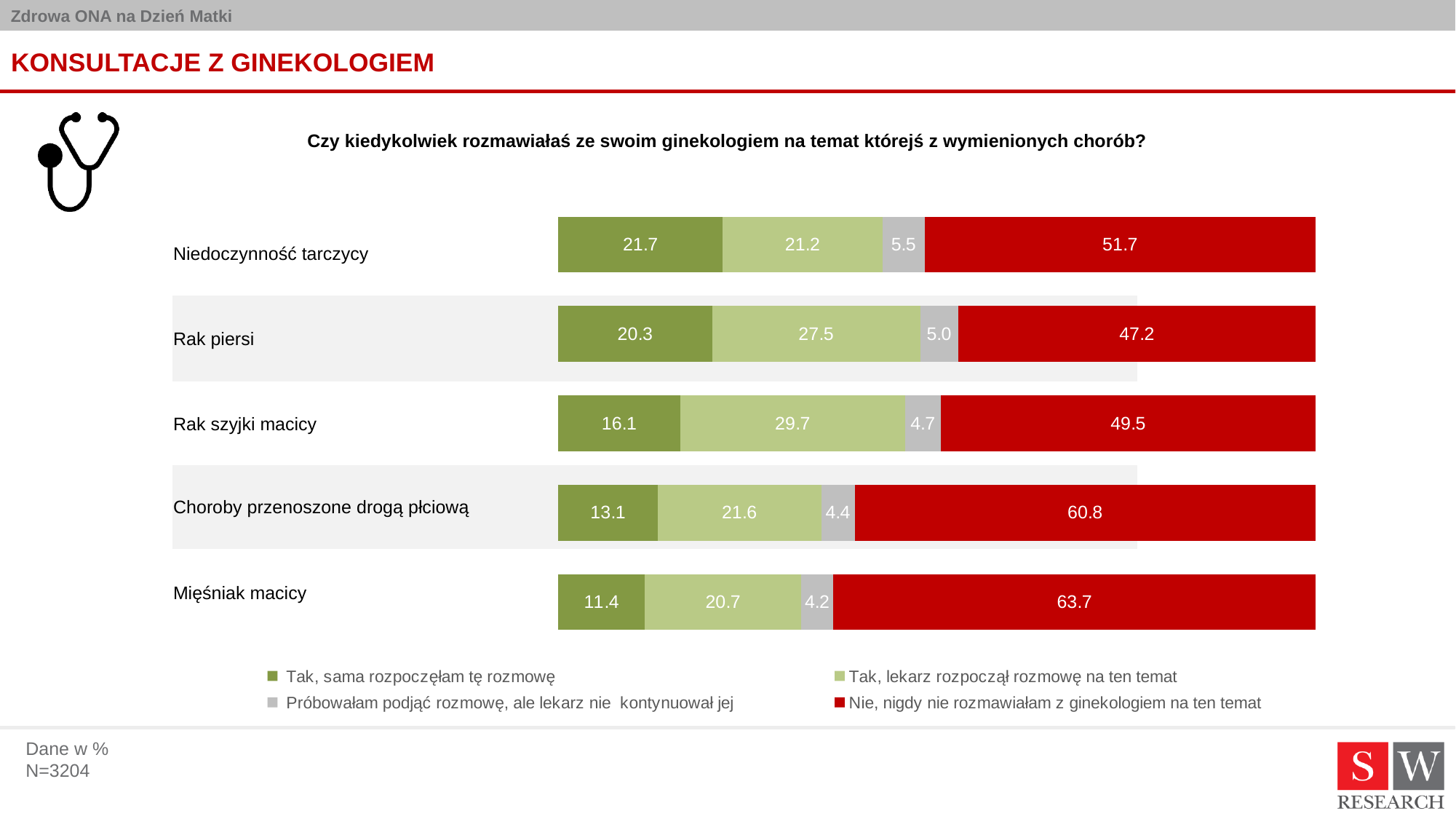
How many categories (diseases) are shown in the chart? 5 What is the value for "Nie, nigdy nie rozmawiałam z ginekologiem na ten temat" for Niedoczynność tarczycy? 51.7 What is the total of the stacked bar for Rak piersi? 100.0 Which category has the lowest value for "Tak, sama rozpoczęłam tę rozmowę"? Mięśniak macicy What is the value for "Tak, lekarz rozpoczął rozmowę na ten temat" for Rak piersi? 27.5 What kind of chart is shown on the slide? Stacked bar chart Which category has the highest value for "Nie, nigdy nie rozmawiałam z ginekologiem na ten temat"? Mięśniak macicy What is the value for "Próbowałam podjąć rozmowę, ale lekarz nie kontynuował jej" for Mięśniak macicy? 4.2 What is the difference between the "Nie, nigdy nie rozmawiałam" values for Mięśniak macicy and Niedoczynność tarczycy? 12.0 Which category has the highest value for "Tak, lekarz rozpoczął rozmowę na ten temat"? Rak szyjki macicy Which is larger: the "Nie, nigdy nie rozmawiałam" value for Rak piersi or for Rak szyjki macicy? Rak szyjki macicy How many series does the legend list? 4